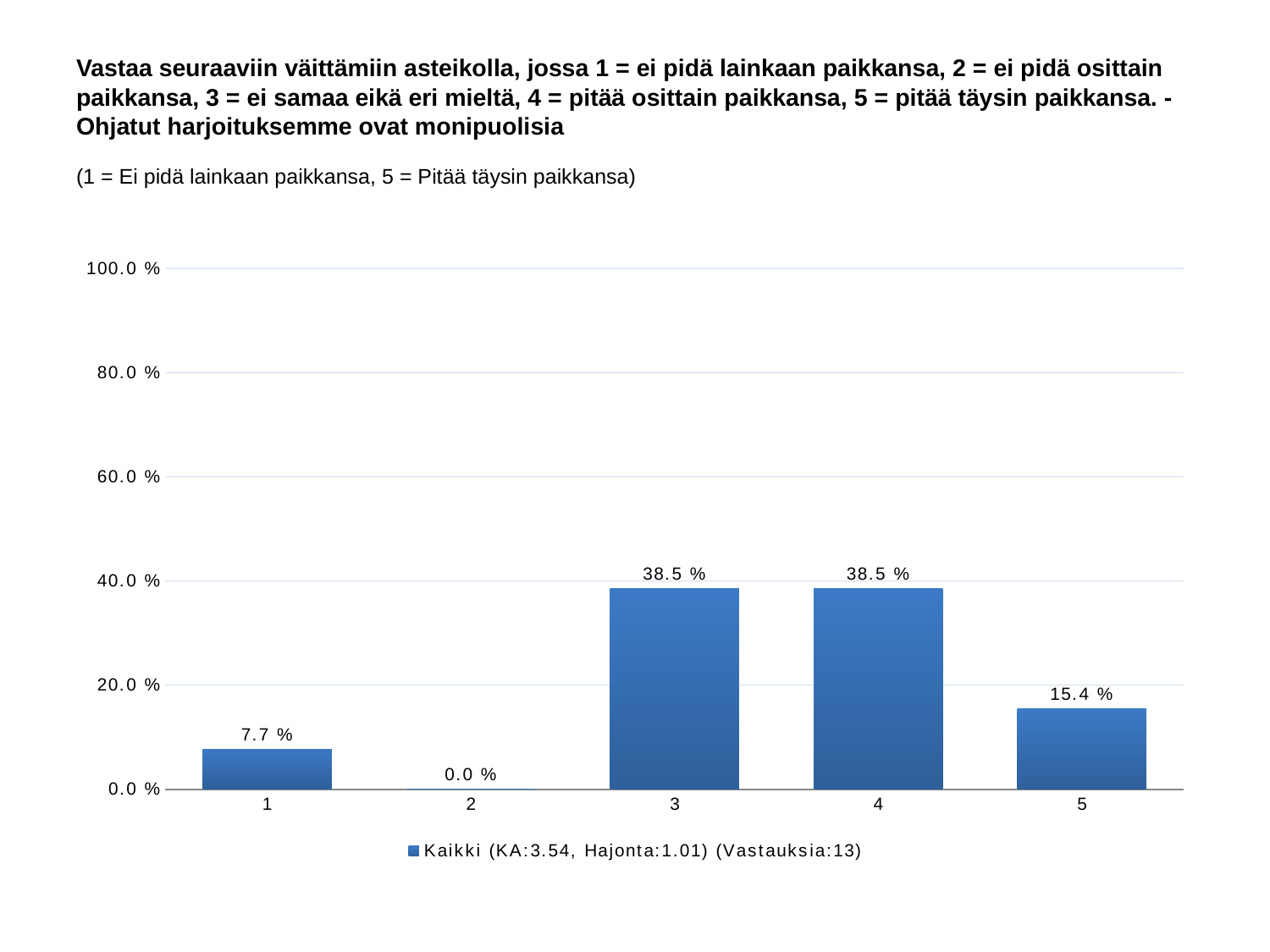
What is the value for category 3? 38.5 % Which is larger, the value for category 5 or the value for category 1? 5 How many responses (Vastauksia) does the legend report? 13 Is the value for category 4 greater or less than 20.0 %? greater Which category has the lowest value? 2 What kind of chart is shown? bar chart What is the difference between the values for category 5 and category 1? 7.7 % What is the value for category 2? 0.0 % What is the value for category 1? 7.7 % How many categories are shown on the x axis? 5 What is the value for category 5? 15.4 % What is the difference between the values for category 3 and category 5? 23.1 %